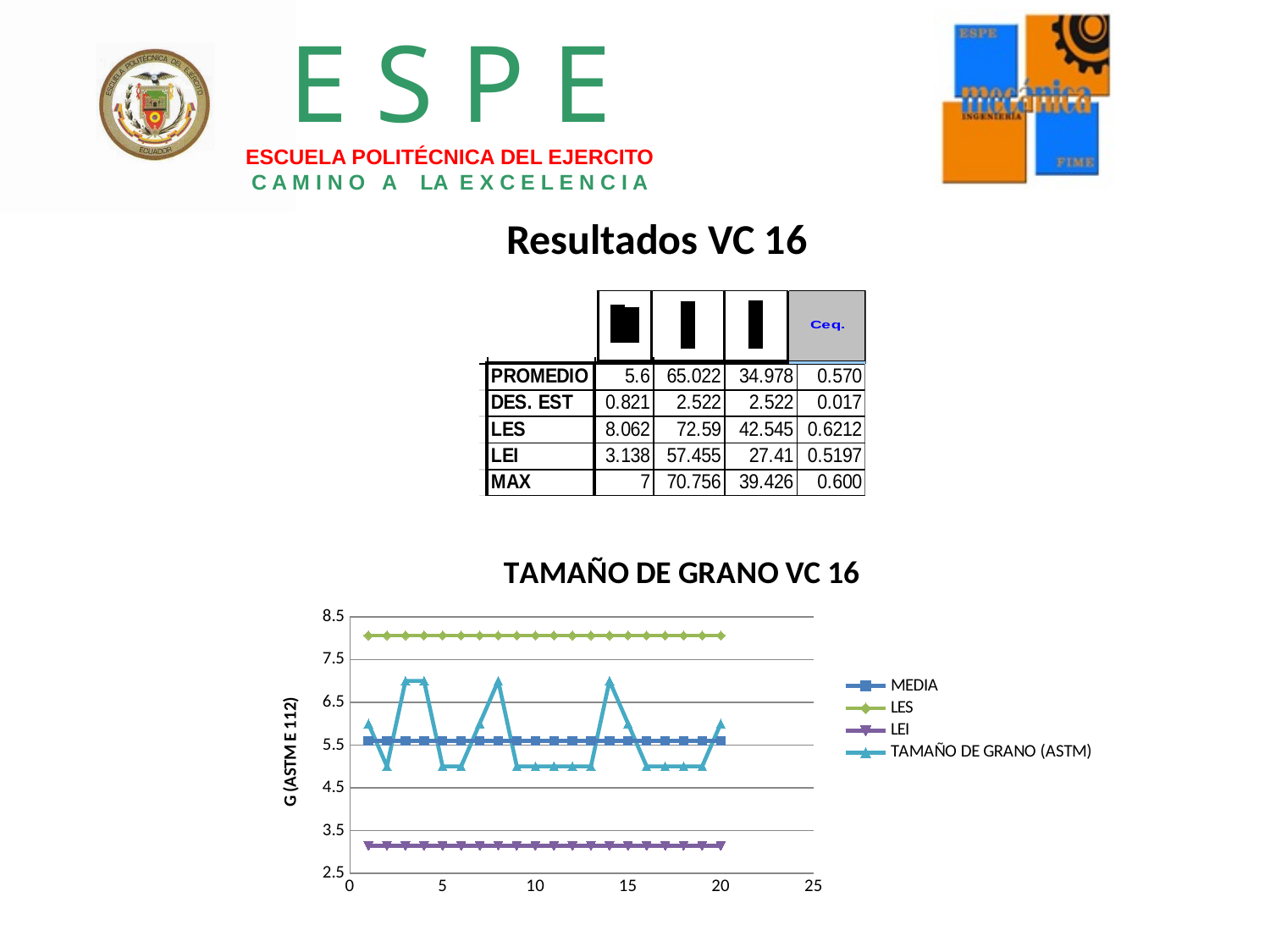
What is the label on the vertical axis of the "TAMAÑO DE GRANO VC 16" chart? G (ASTM E 112) In the "TAMAÑO DE GRANO VC 16" chart, does the LES line rise, fall, or stay flat along the x axis? stay flat What is the title of the chart on the slide? TAMAÑO DE GRANO VC 16 In the "TAMAÑO DE GRANO VC 16" chart, is the LES line greater or less than 7.5? greater Which series in the "TAMAÑO DE GRANO VC 16" chart has the lowest values? LEI What kind of chart is shown under the title "TAMAÑO DE GRANO VC 16"? line chart In the "TAMAÑO DE GRANO VC 16" chart, is the LEI line greater or less than 3.5? less In the "TAMAÑO DE GRANO VC 16" chart, is the highest point of the TAMAÑO DE GRANO (ASTM) series greater or less than 7.5? less Which series in the "TAMAÑO DE GRANO VC 16" chart has the highest values? LES How many series does the legend of the "TAMAÑO DE GRANO VC 16" chart list? 4 In the "TAMAÑO DE GRANO VC 16" chart, which series is larger, LES or LEI? LES